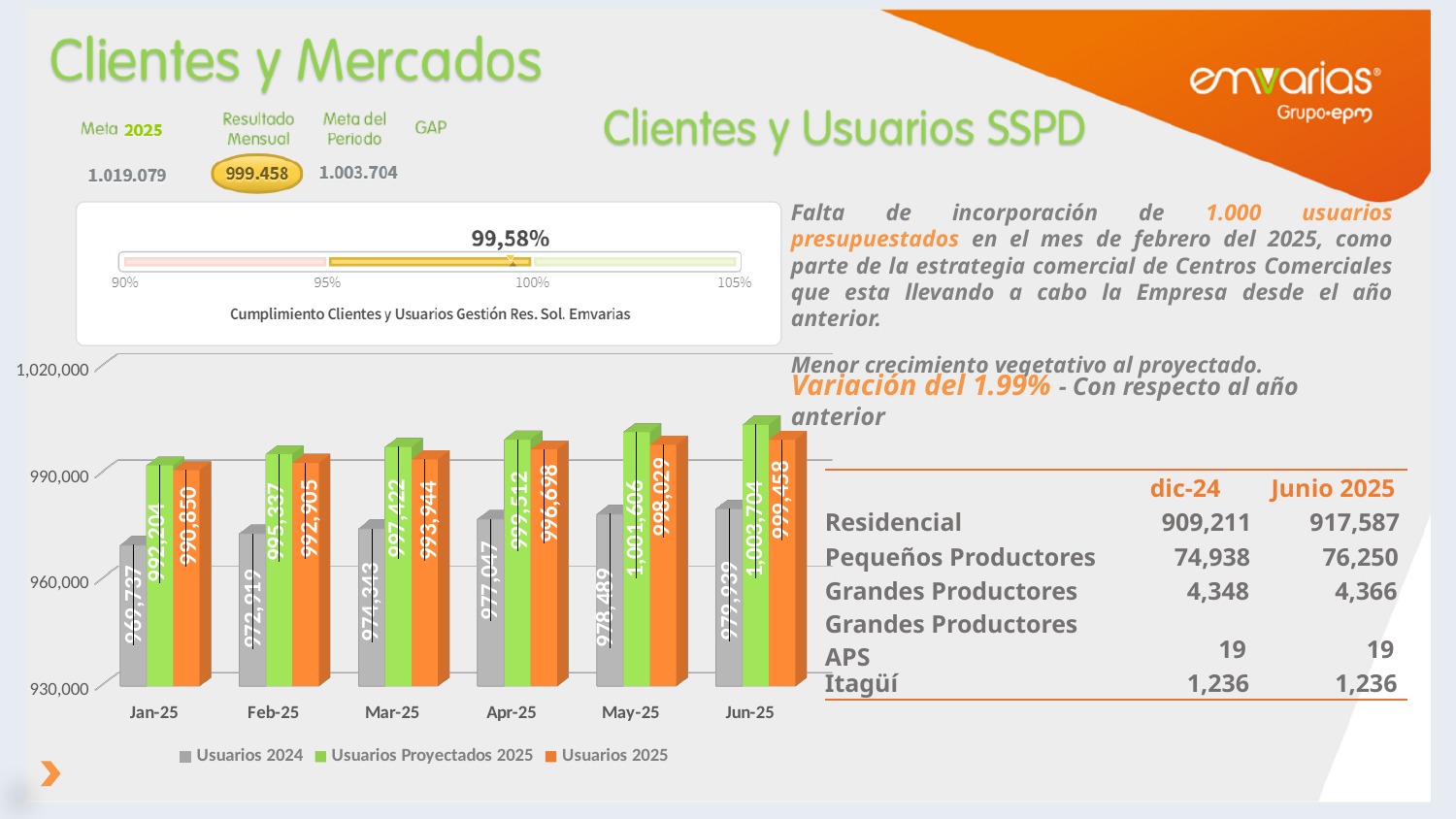
In the bar chart, what is the value of Usuarios 2025 for Apr-25? 996,698 In the bar chart, is the value of Usuarios 2024 for Jan-25 greater or less than 990,000? less In the bar chart, what is the difference between Usuarios Proyectados 2025 and Usuarios 2025 for Jun-25? 4,246 In the bar chart, which month has the highest value for Usuarios Proyectados 2025? Jun-25 In the bar chart, what is the value of Usuarios 2025 for Jun-25? 999,458 What kind of chart is used to show Usuarios 2024, Usuarios Proyectados 2025 and Usuarios 2025 by month? Bar chart How many months are shown on the x axis of the bar chart? 6 In the bar chart, do the Usuarios 2025 values rise or fall from Jan-25 to Jun-25? Rise How many series does the legend of the monthly bar chart list? 3 In the bar chart, which is larger for Jan-25: Usuarios Proyectados 2025 or Usuarios 2025? Usuarios Proyectados 2025 In the bar chart, what is the value of Usuarios Proyectados 2025 for Mar-25? 997,422 What percentage is displayed on the gauge labelled Cumplimiento Clientes y Usuarios Gestión Res. Sol. Emvarias? 99,58%